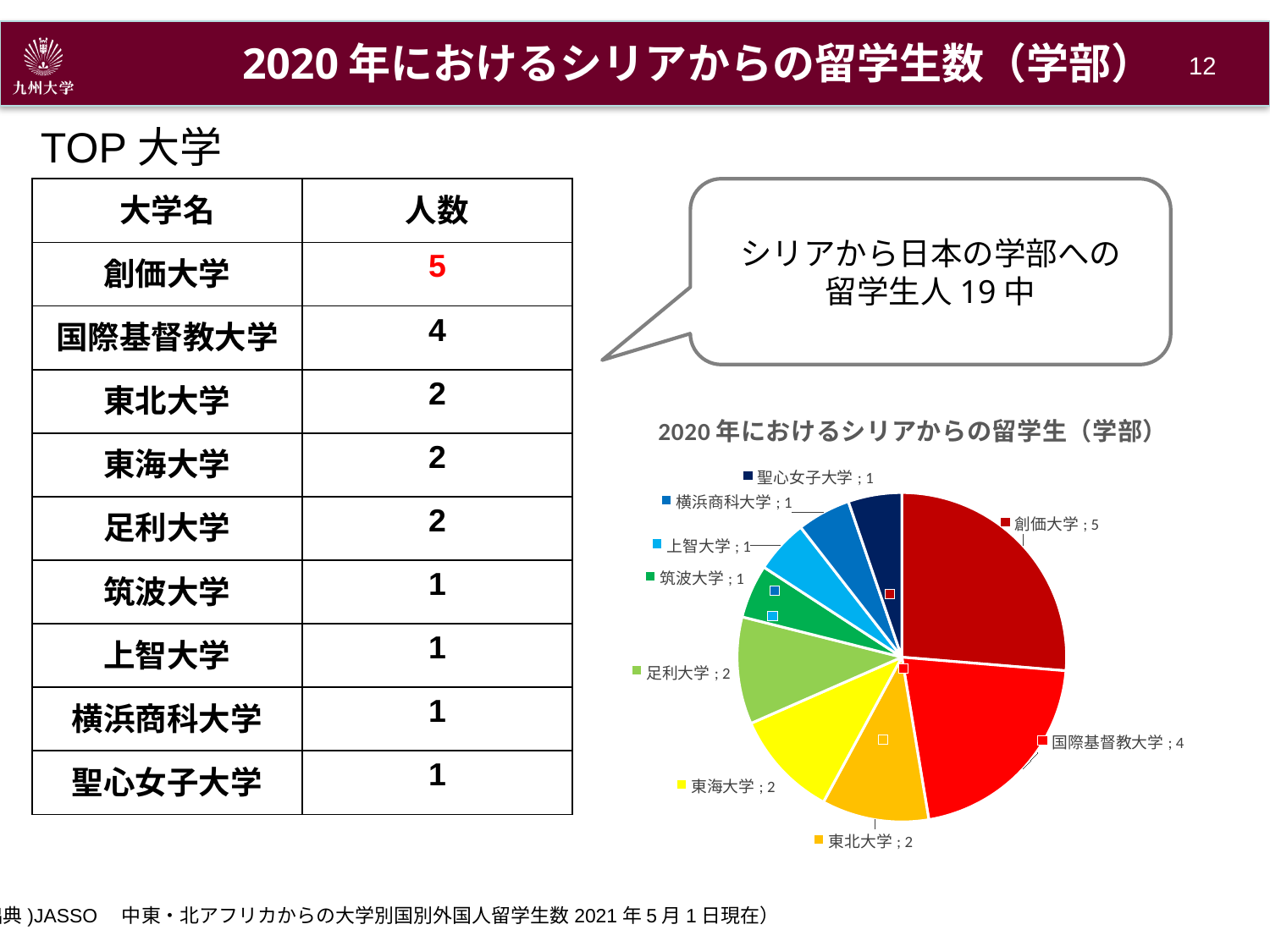
How many slices does the pie chart have? 9 What is the difference between the values for 創価大学 and 国際基督教大学 in the pie chart? 1 What is the value for 創価大学 in the pie chart? 5 What type of chart is shown on the slide? pie chart What is the value for 国際基督教大学 in the pie chart? 4 What is the value for 東北大学 in the pie chart? 2 Which university has the largest slice in the pie chart? 創価大学 What is the difference between the values for 東海大学 and 聖心女子大学 in the pie chart? 1 Which is larger in the pie chart, the value for 足利大学 or the value for 筑波大学? 足利大学 What is the title of the pie chart? 2020年におけるシリアからの留学生（学部） What is the value for 上智大学 in the pie chart? 1 What is the total of all slices in the pie chart? 19